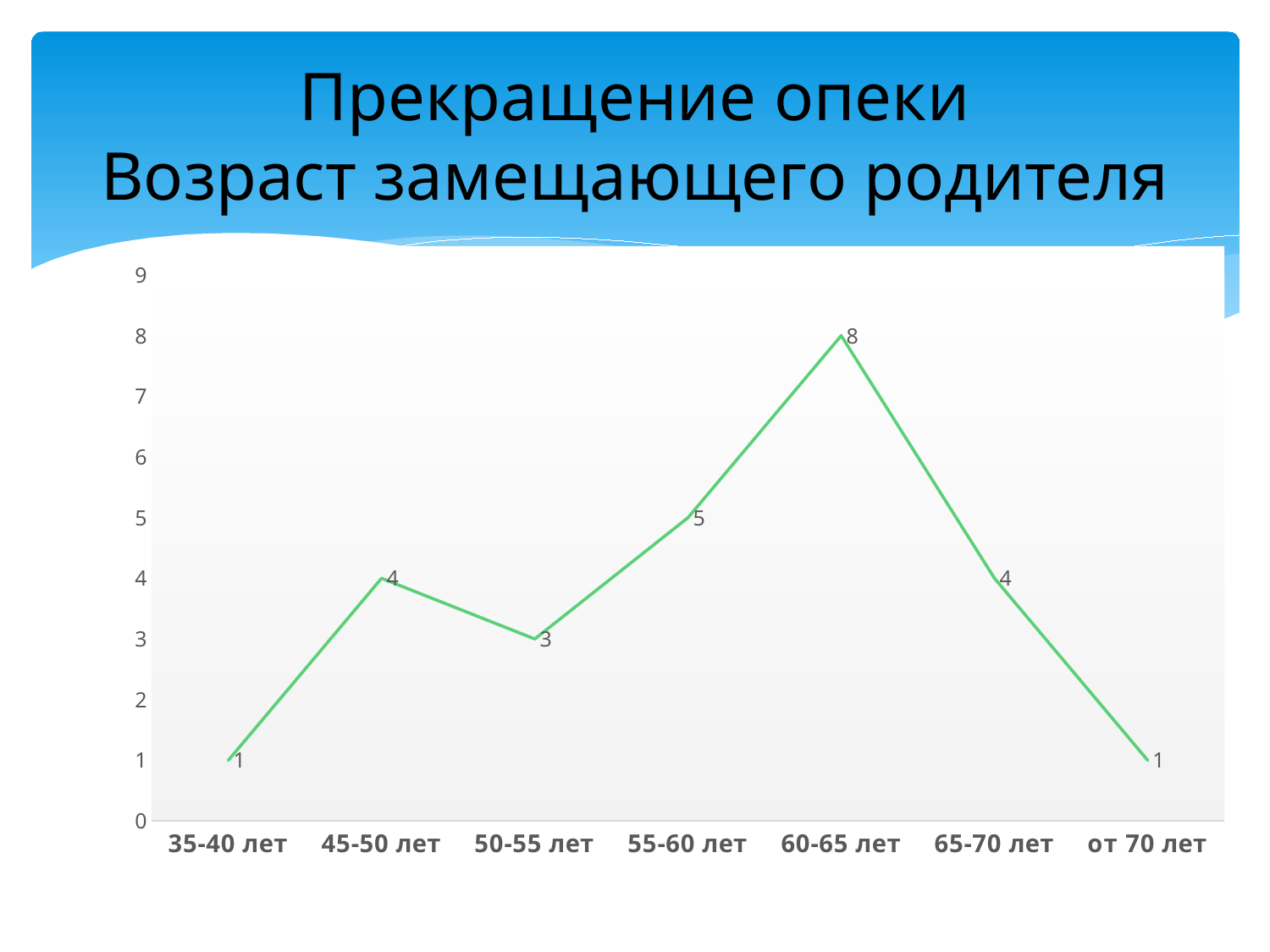
What is the value for 55-60 лет? 5 What is the value for 60-65 лет? 8 What is the difference between the values for 55-60 лет and 35-40 лет? 4 How many age categories are plotted on the x axis? 7 Which is larger, the value for 45-50 лет or the value for 50-55 лет? 45-50 лет Which age category has the highest value? 60-65 лет What is the value for от 70 лет? 1 What is the difference between the values for 60-65 лет and 65-70 лет? 4 What is the value for 50-55 лет? 3 What kind of chart is shown on the slide? line chart What is the title of the slide containing the chart? Прекращение опеки Возраст замещающего родителя Does the line rise or fall from 60-65 лет to от 70 лет? fall